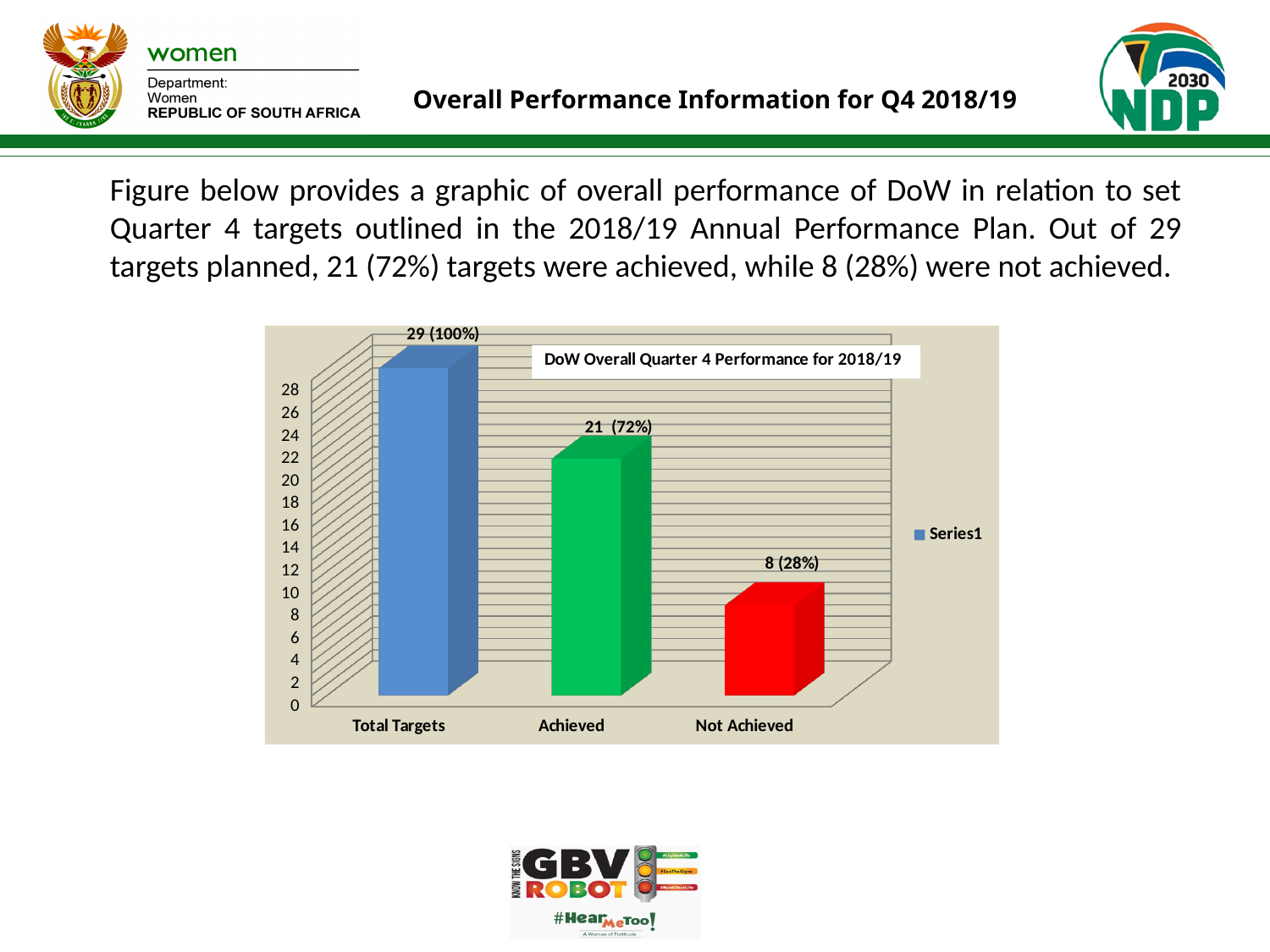
What kind of chart is shown on the slide? bar chart What is the title of the chart? DoW Overall Quarter 4 Performance for 2018/19 What is the data label shown for Not Achieved? 8 (28%) How many categories are shown on the x axis? 3 Is the value for Achieved greater or less than 20? greater What is the difference between the Achieved and Not Achieved values? 13 Which category has the lowest value? Not Achieved Which is larger, the value for Achieved or the value for Not Achieved? Achieved What is the data label shown for Achieved? 21 (72%) Which category has the highest value? Total Targets What is the data label shown for Total Targets? 29 (100%) How many series does the legend list? 1